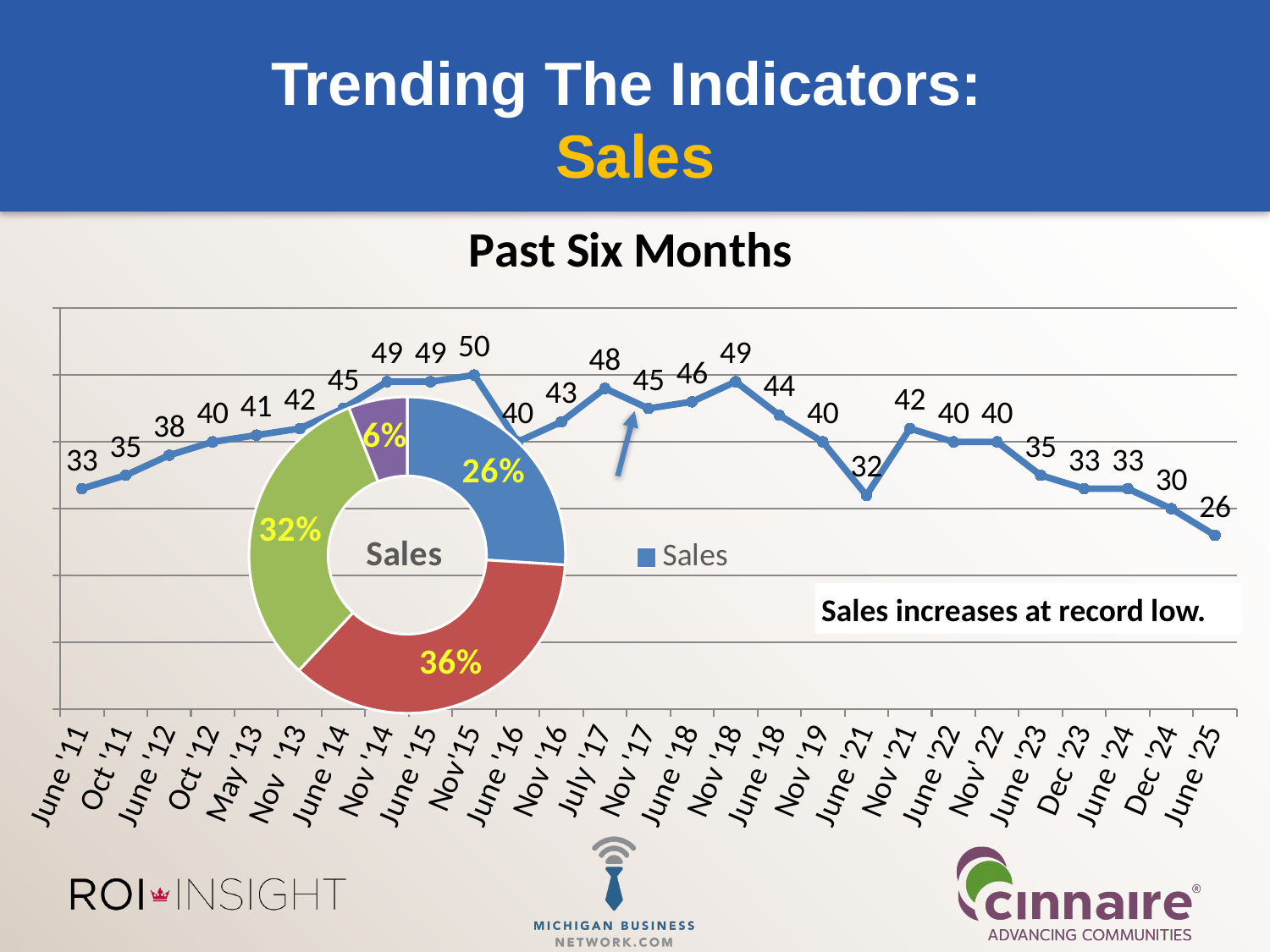
What kind of chart is the "Past Six Months" chart? line chart In the line chart titled "Past Six Months", what is the value for June '25? 26 In the line chart titled "Past Six Months", do the values rise or fall from June '22 to June '25? fall In the line chart titled "Past Six Months", what is the value for Nov '15? 50 How many slices does the doughnut chart labelled "Sales" have? 4 In the line chart titled "Past Six Months", what is the value for June '21? 32 In the line chart titled "Past Six Months", which period has the lowest value? June '25 In the doughnut chart labelled "Sales", what is the share of the largest slice? 36% In the line chart titled "Past Six Months", which is larger, the value for June '21 or the value for Nov '21? Nov '21 In the line chart titled "Past Six Months", which period has the highest value? Nov '15 In the line chart titled "Past Six Months", what is the difference between the value for Nov '15 and the value for June '25? 24